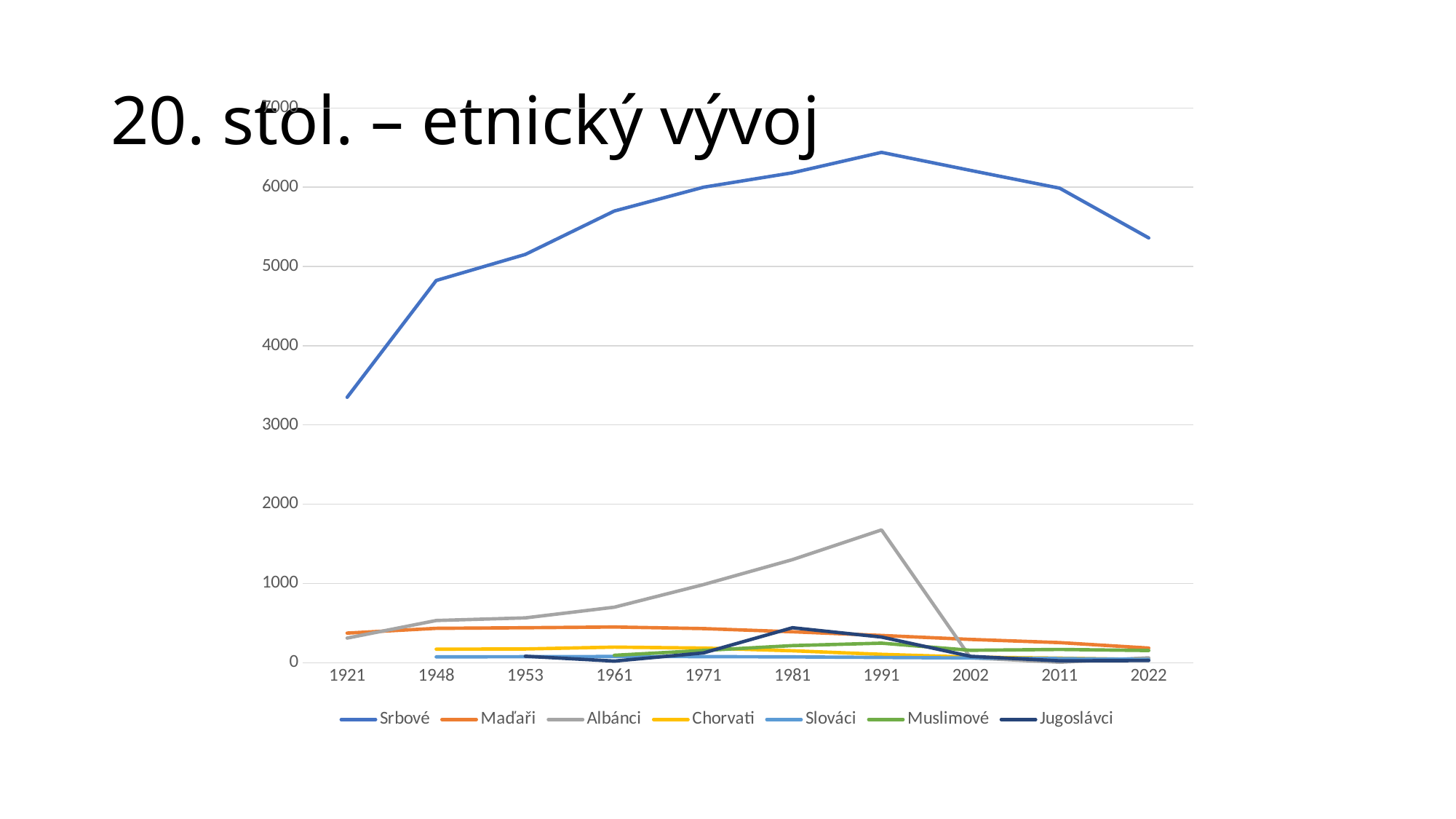
Is the value for Srbové in 1921 greater or less than 4000? less Which series is larger in 1981, Srbové or Maďaři? Srbové How many years are shown along the x axis? 10 In which year does the Srbové series reach its highest value? 1991 In which year does the Albánci series reach its highest value? 1991 Does the Srbové series rise or fall between 1921 and 1991? rise Is the value for Srbové in 1991 greater or less than 6000? greater How many series does the legend list? 7 In which year does the Srbové series have its lowest value? 1921 Which series is drawn in grey in the legend? Albánci What kind of chart is shown on the slide? line chart Is the value for Albánci in 1991 greater or less than 1000? greater